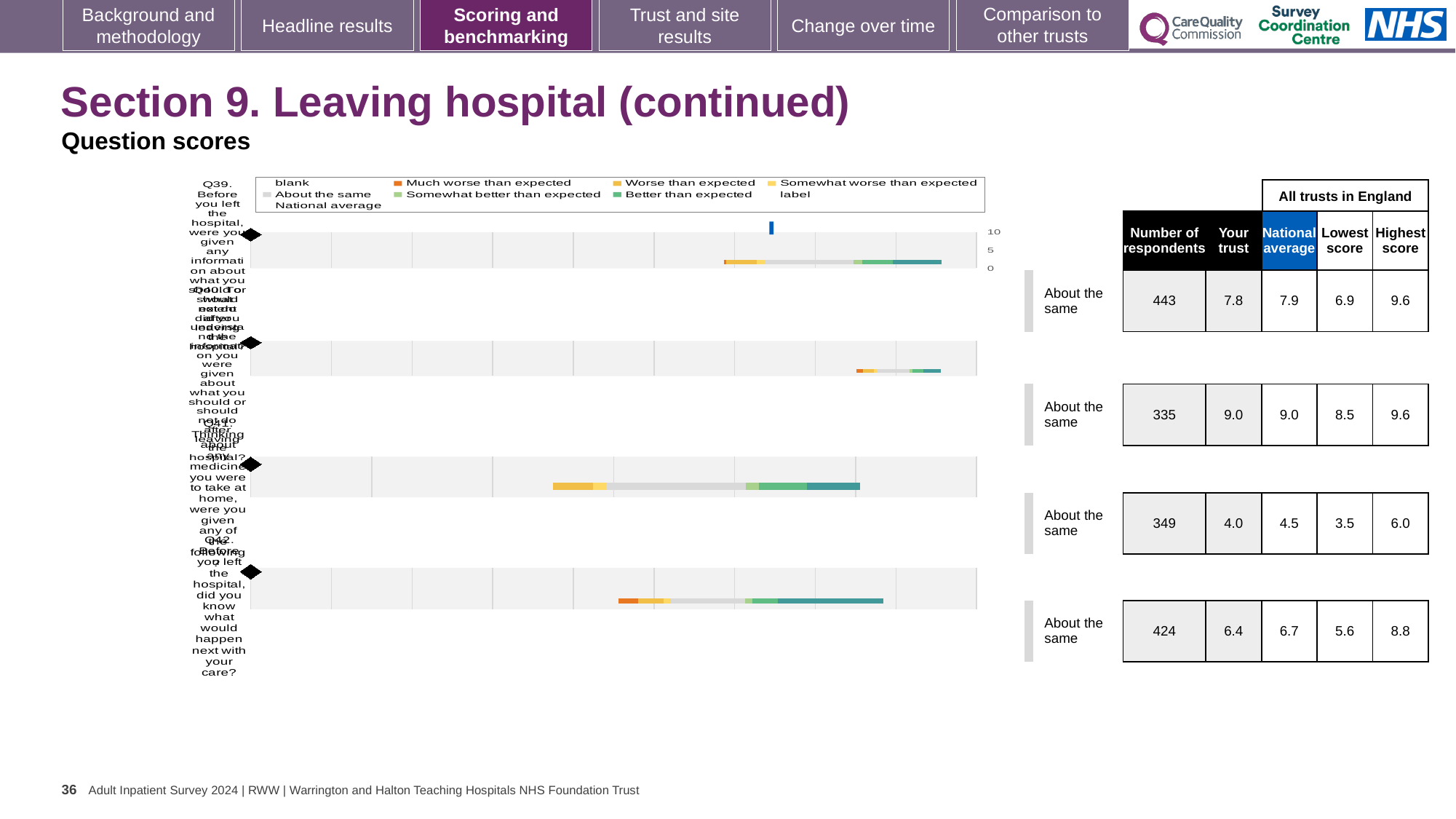
In the first row (Q39), which is larger: the 'Your trust' score or the national average? national average In the table beside the chart, what is the 'Your trust' score for the second row (Q40)? 9.0 Which row of the table has the lowest 'Your trust' score? the third row (Q41), 4.0 What is the heading above the 'National average', 'Lowest score' and 'Highest score' columns of the table? All trusts in England What kind of chart is shown on the slide? bar chart In the third row (Q41), what is the difference between the national average and the 'Your trust' score? 0.5 In the table beside the chart, what is the highest score for the fourth row (Q42)? 8.8 What benchmark label is shown next to each of the four bars? About the same In the table beside the chart, what is the number of respondents for the first row (Q39)? 443 In the table beside the chart, what is the national average for the third row (Q41)? 4.5 How many question bars are plotted in the chart? 4 Which row of the table has the highest 'Your trust' score? the second row (Q40), 9.0